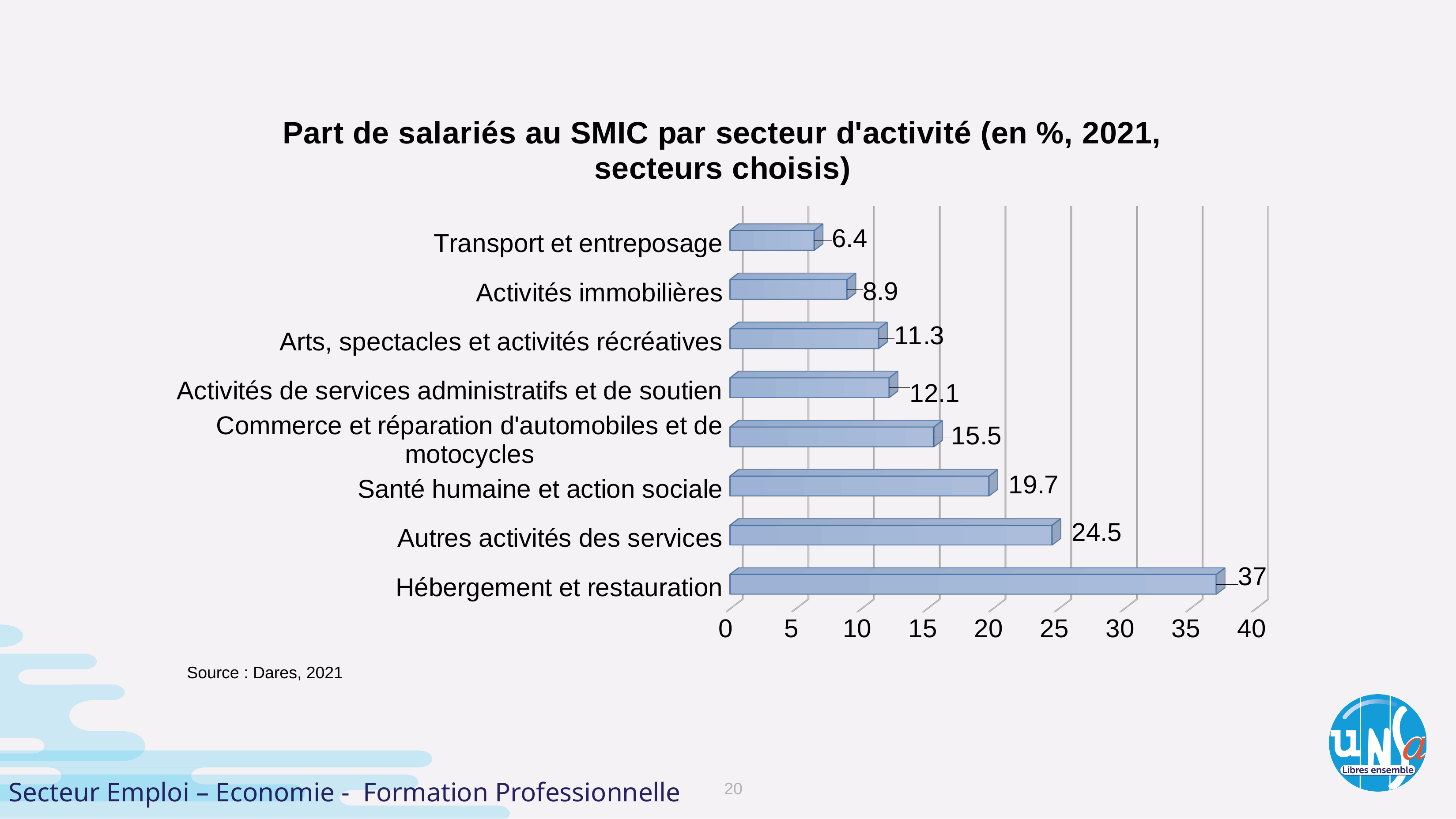
Which sector has the highest share of employees at the SMIC? Hébergement et restauration Which is larger: the value for Arts, spectacles et activités récréatives or the value for Activités de services administratifs et de soutien? Activités de services administratifs et de soutien How many sectors are shown in the chart? 8 What is the difference between the values for Autres activités des services and Santé humaine et action sociale? 4.8 Which sector has the lowest share of employees at the SMIC? Transport et entreposage What kind of chart is shown on the slide? bar chart What is the title of the chart? Part de salariés au SMIC par secteur d'activité (en %, 2021, secteurs choisis) What is the value for Santé humaine et action sociale? 19.7 Is the value for Commerce et réparation d'automobiles et de motocycles greater or less than 20? less What is the value for Activités immobilières? 8.9 What source is cited below the chart? Dares, 2021 What is the value for Hébergement et restauration? 37